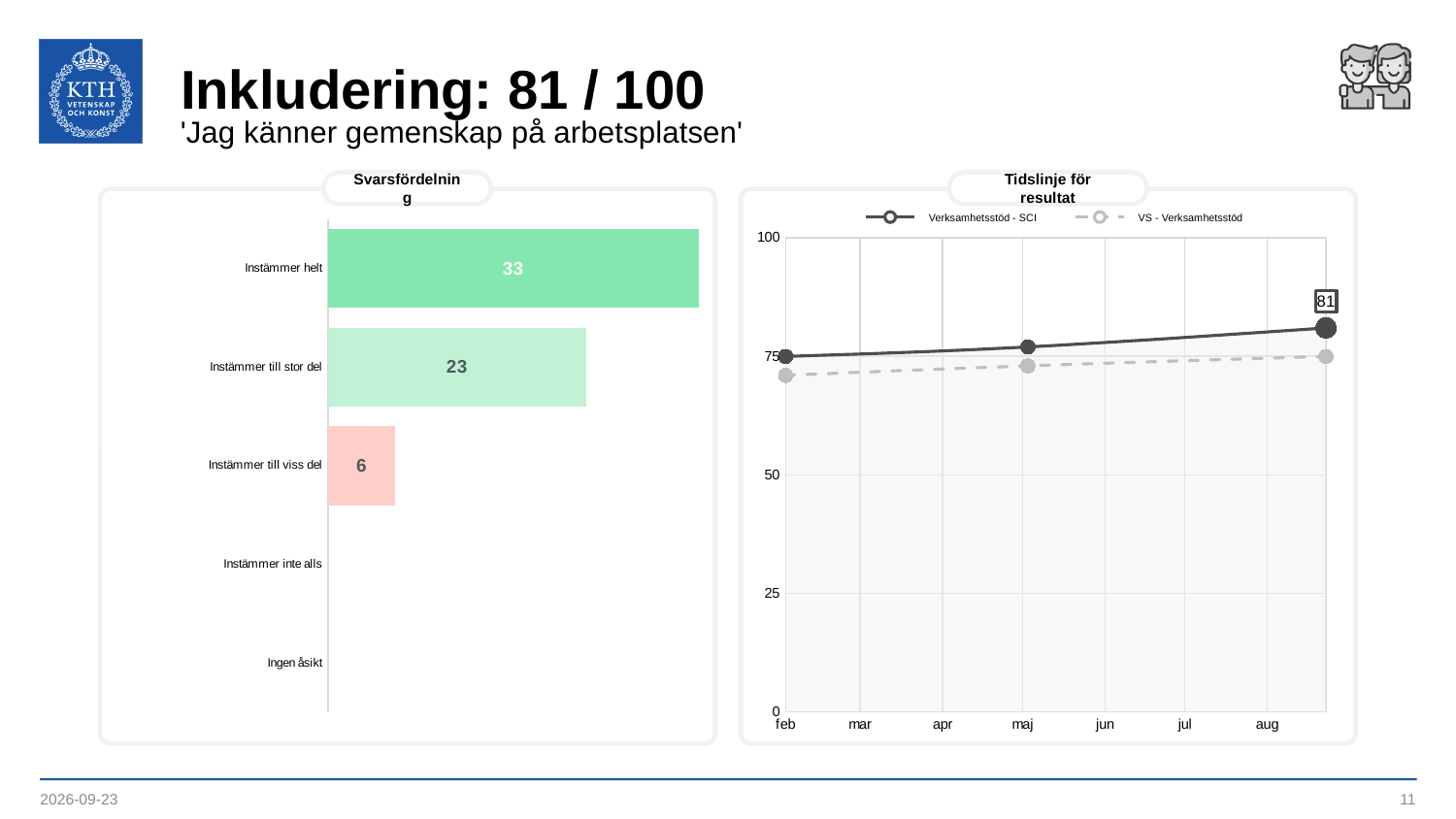
In the 'Tidslinje för resultat' chart, is the value of the 'VS - Verksamhetsstöd' series at feb greater or less than 75? less What kind of chart is the 'Svarsfördelning' chart? bar chart In the 'Svarsfördelning' chart, what is the difference between 'Instämmer helt' and 'Instämmer till stor del'? 10 In the 'Svarsfördelning' chart, what is the value for 'Instämmer helt'? 33 In the 'Svarsfördelning' chart, which category has the highest value? Instämmer helt In the 'Svarsfördelning' chart, which is larger: 'Instämmer till stor del' or 'Instämmer till viss del'? Instämmer till stor del In the 'Svarsfördelning' chart, what is the value for 'Instämmer till viss del'? 6 In the 'Svarsfördelning' chart, how many categories are listed on the axis? 5 In the 'Tidslinje för resultat' chart, what is the labelled value of the last point of the 'Verksamhetsstöd - SCI' series? 81 In the 'Svarsfördelning' chart, what is the value for 'Instämmer till stor del'? 23 How many series does the legend of the 'Tidslinje för resultat' chart list? 2 In the 'Tidslinje för resultat' chart, does the 'Verksamhetsstöd - SCI' series rise or fall from feb to the last point? rise